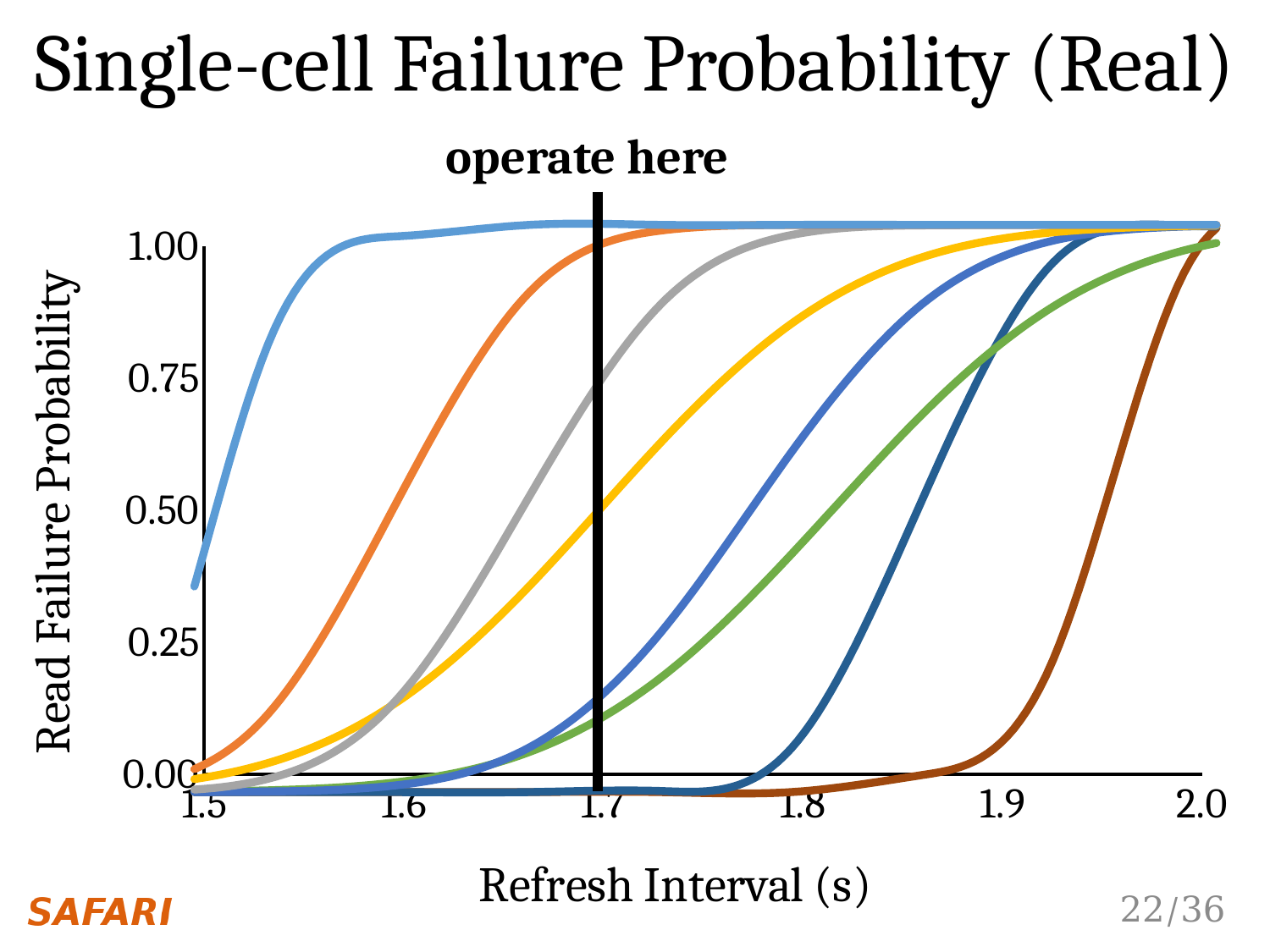
Is the value of the brown curve at a refresh interval of 1.9 greater or less than 0.25? less What is the label of the x axis? Refresh Interval (s) Is the value of the light blue curve at a refresh interval of 1.7 greater or less than 0.75? greater Do the curves rise or fall as the refresh interval increases? rise How many curves are plotted on the chart? 8 Is the value of the brown curve at a refresh interval of 1.7 greater or less than 0.25? less What kind of chart is shown on the slide? line chart At what refresh interval is the vertical 'operate here' line drawn? 1.7 Which curve reaches a read failure probability of 1.00 at the smallest refresh interval? the light blue curve What is the title of the chart? Single-cell Failure Probability (Real) At a refresh interval of 1.7, which curve has the higher read failure probability, the orange curve or the brown curve? the orange curve